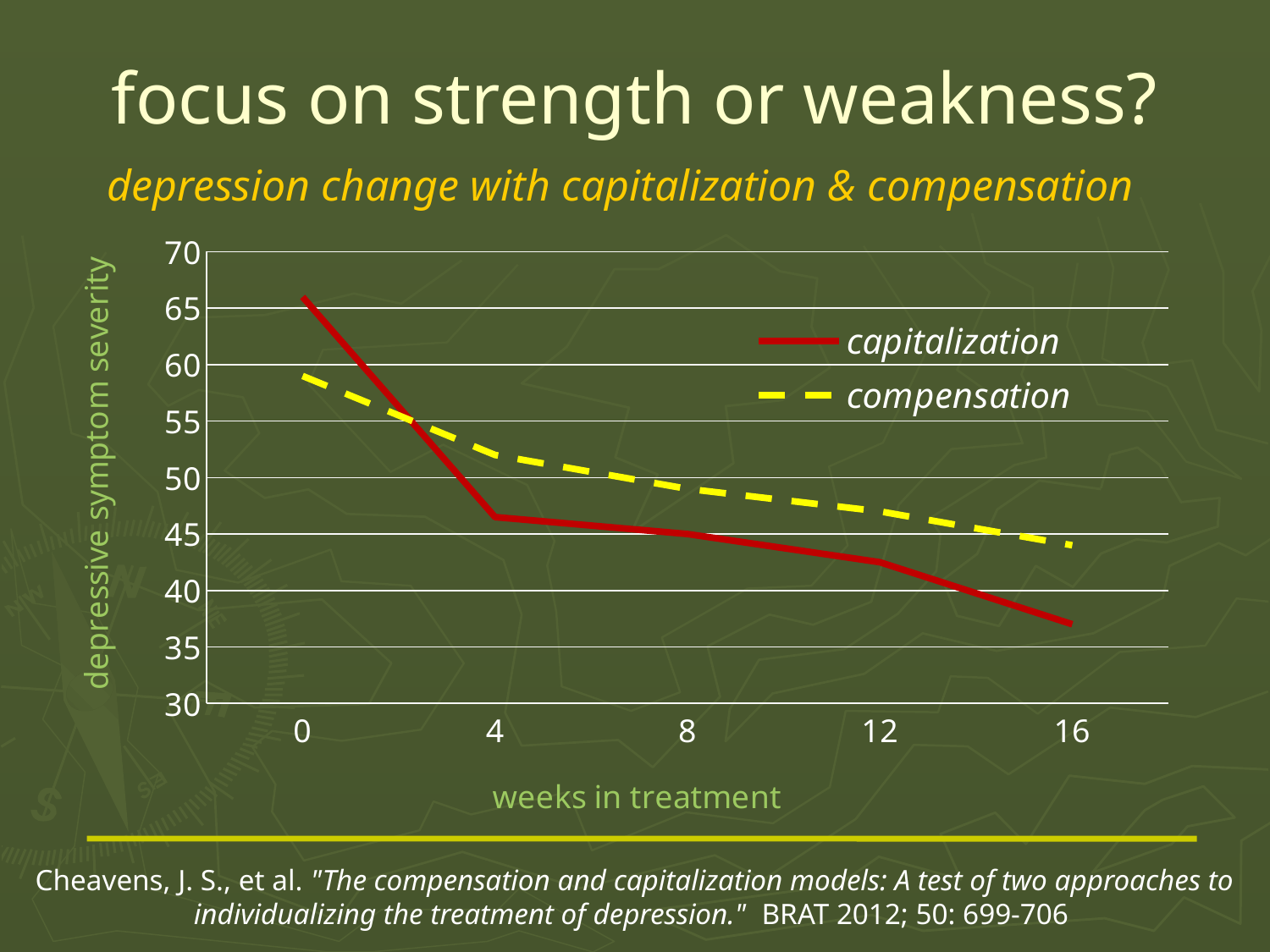
At week 0, which series has the higher depressive symptom severity, capitalization or compensation? capitalization Is the capitalization value at week 0 greater or less than 60? greater Does depressive symptom severity for the compensation series rise or fall as weeks in treatment increase? fall Does depressive symptom severity for the capitalization series rise or fall as weeks in treatment increase? fall What is the label of the x axis? weeks in treatment What kind of chart is shown on the slide? line chart Is the compensation value at week 4 greater or less than 50? greater Is the compensation value at week 16 greater or less than 50? less How many time points (weeks) are plotted along the x axis? 5 At week 16, which series has the higher depressive symptom severity, capitalization or compensation? compensation How many series does the legend list? 2